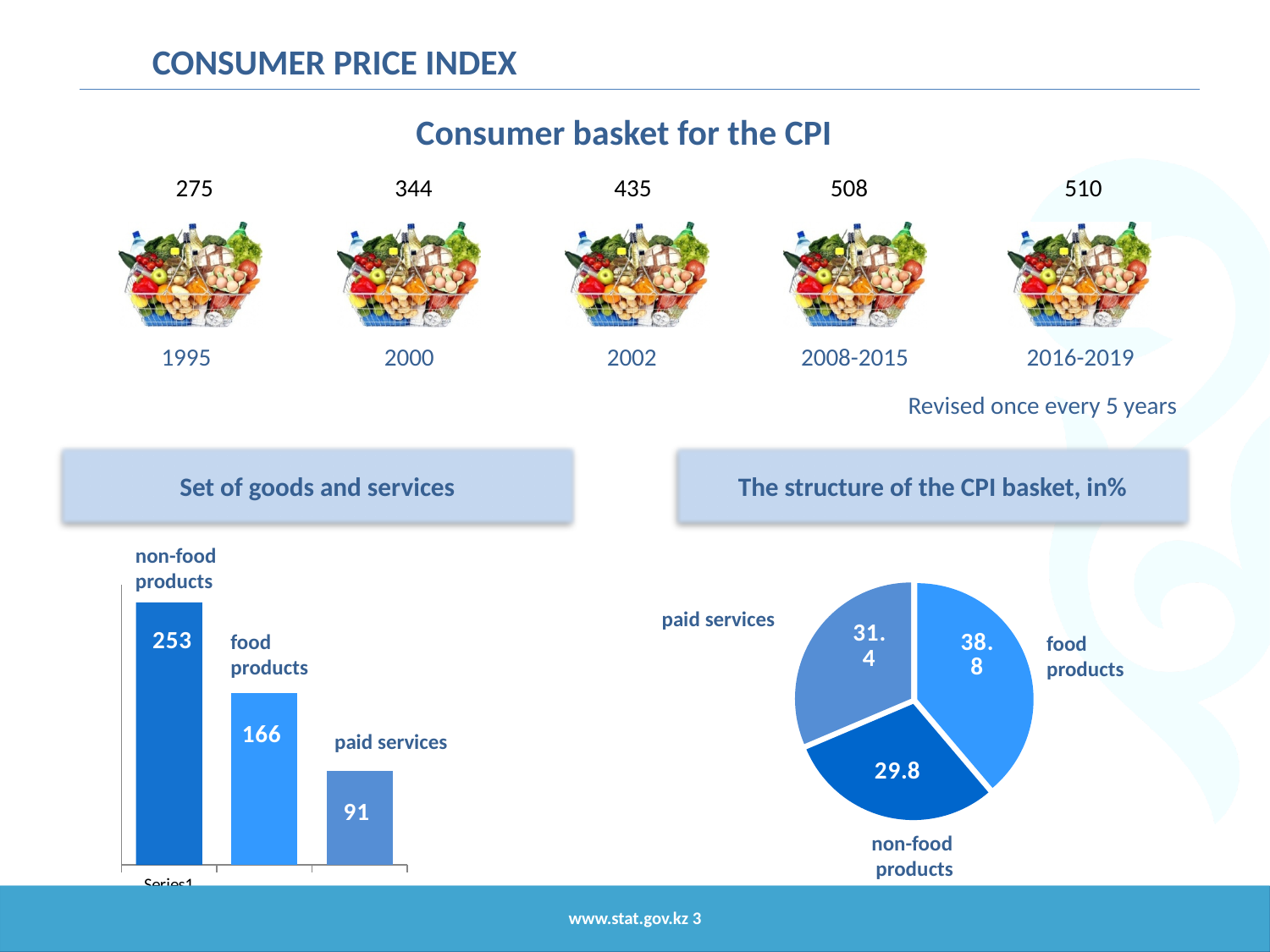
In the 'Set of goods and services' chart, how many categories are shown? 3 In the 'Set of goods and services' chart, which category has the highest value? non-food products In the 'Set of goods and services' chart, what is the value for non-food products? 253 What kind of chart is 'The structure of the CPI basket, in%'? pie chart In the 'Set of goods and services' chart, what is the difference between non-food products and food products? 87 What kind of chart is 'Set of goods and services'? bar chart In 'The structure of the CPI basket, in%' chart, which is larger: paid services or non-food products? paid services In 'The structure of the CPI basket, in%' chart, what is the share for non-food products? 29.8 In the 'Set of goods and services' chart, what is the value for paid services? 91 In the 'Set of goods and services' chart, which category has the lowest value? paid services In 'The structure of the CPI basket, in%' chart, what is the share for food products? 38.8 In 'The structure of the CPI basket, in%' chart, which slice is the largest? food products